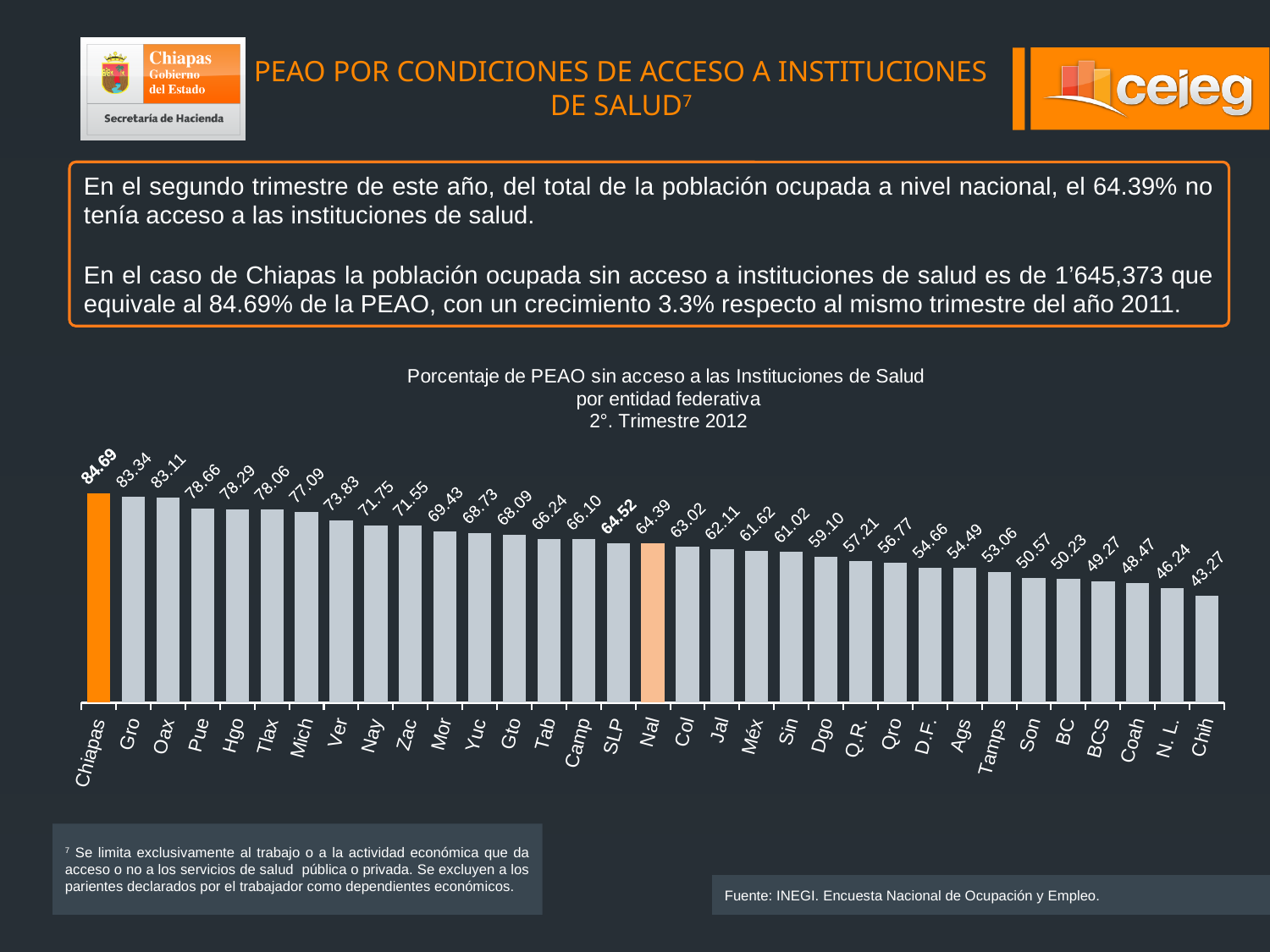
What is the value shown for Nal (national) in the chart? 64.39 Which has a larger value, Ver or Dgo? Ver Which entity has the lowest value in the chart? Chih Do the values rise or fall from left to right along the x axis? Fall Which entity has the highest value in the chart? Chiapas What is the value shown for Chiapas in the chart? 84.69 What type of chart is shown on the slide? Bar chart What is the difference between the values for Chiapas and Nal? 20.30 What is the value shown for Jal in the chart? 62.11 What is the difference between the values for Gro and Oax? 0.23 What is the value shown for Chih in the chart? 43.27 How many bars are plotted in the chart? 33